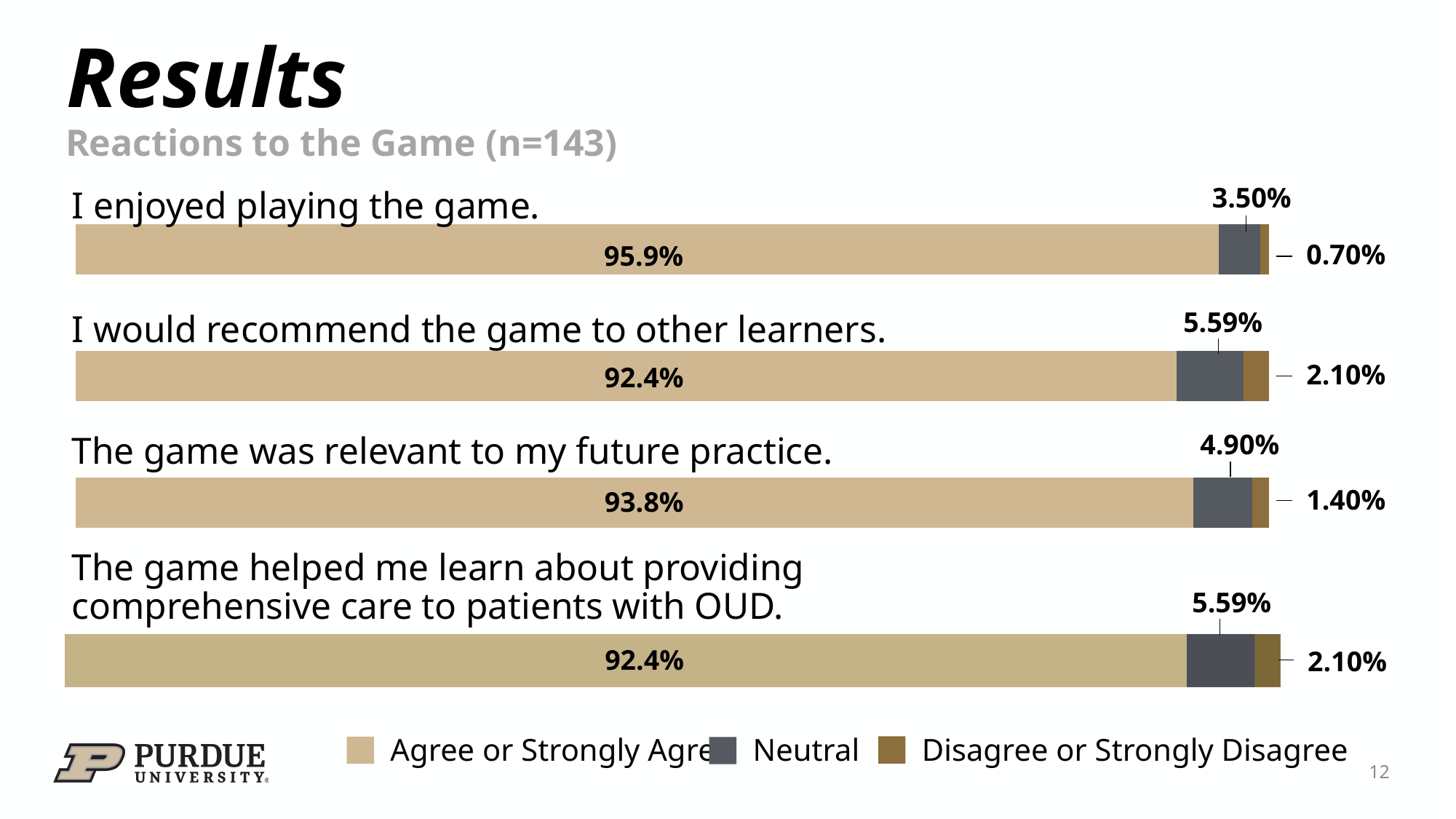
Which statement has the highest Agree or Strongly Agree percentage? I enjoyed playing the game. What kind of chart is shown on the slide? Stacked bar chart How many response categories does the legend list? 3 What is the sample size given in the chart subtitle? n=143 What is the Disagree or Strongly Disagree percentage for "The game was relevant to my future practice."? 1.40% How many statements are shown in the chart? 4 Which has a larger Neutral percentage: "The game was relevant to my future practice." or "I enjoyed playing the game."? The game was relevant to my future practice. What is the Disagree or Strongly Disagree percentage for "I enjoyed playing the game."? 0.70% What percentage of respondents agreed or strongly agreed with "I enjoyed playing the game."? 95.9% What is the Neutral percentage for "I would recommend the game to other learners."? 5.59% What is the difference in the Agree or Strongly Agree percentage between "I enjoyed playing the game." and "I would recommend the game to other learners."? 3.5% Which statement has the lowest Neutral percentage? I enjoyed playing the game.